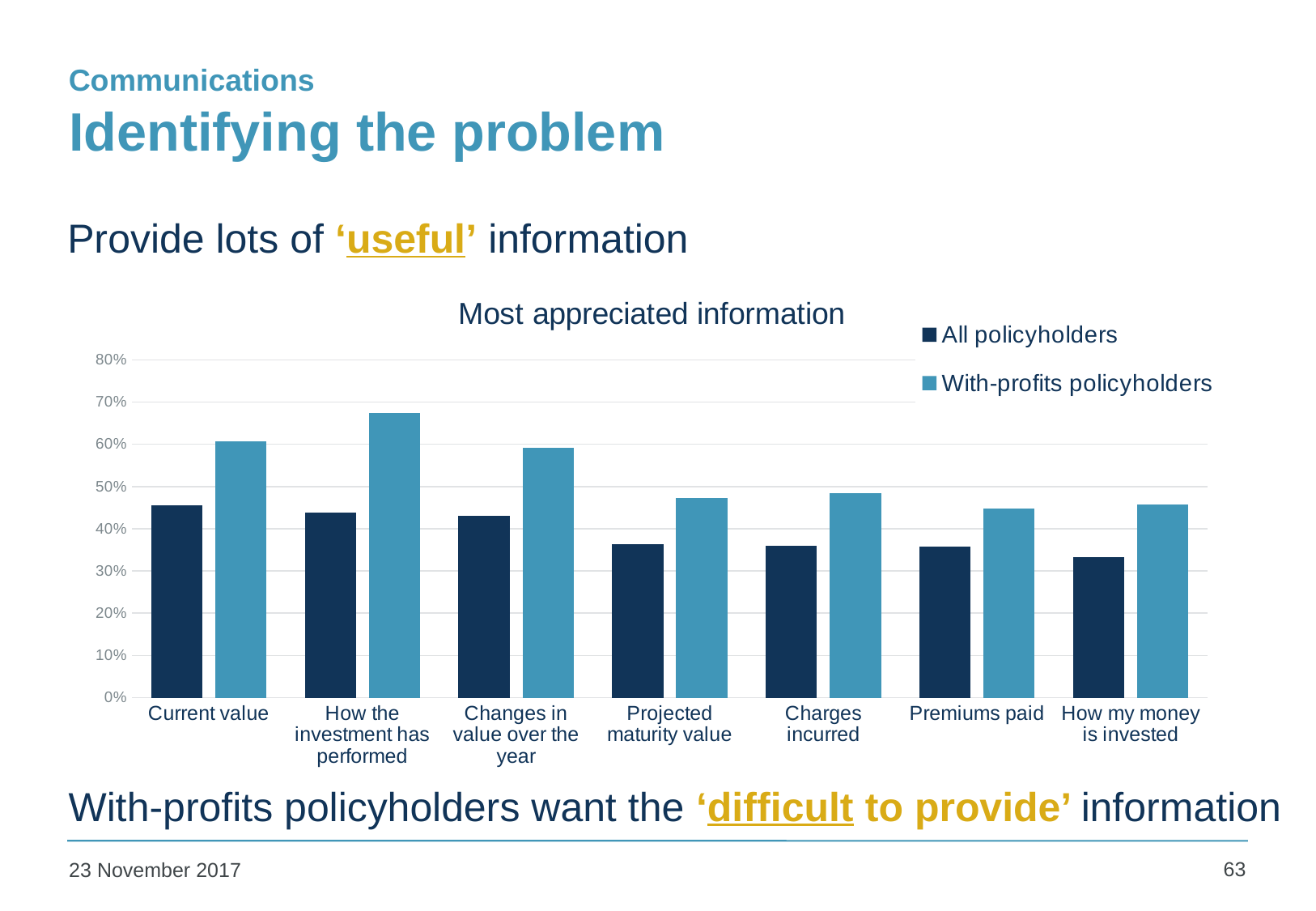
Is the With-profits policyholders value for Current value greater or less than 50%? greater Is the All policyholders value for Projected maturity value greater or less than 40%? less How many categories are shown on the x axis of the chart? 7 What type of chart is shown on the slide? Bar chart Which category has the highest value for With-profits policyholders? How the investment has performed How many series does the chart legend list? 2 Which series is shown in the lighter blue colour in the chart? With-profits policyholders Is the With-profits policyholders value for How the investment has performed greater or less than 60%? greater Which category has the lowest value for All policyholders? How my money is invested For With-profits policyholders, which is larger: Current value or Premiums paid? Current value For Charges incurred, which series has the larger value: All policyholders or With-profits policyholders? With-profits policyholders What is the title of the chart? Most appreciated information